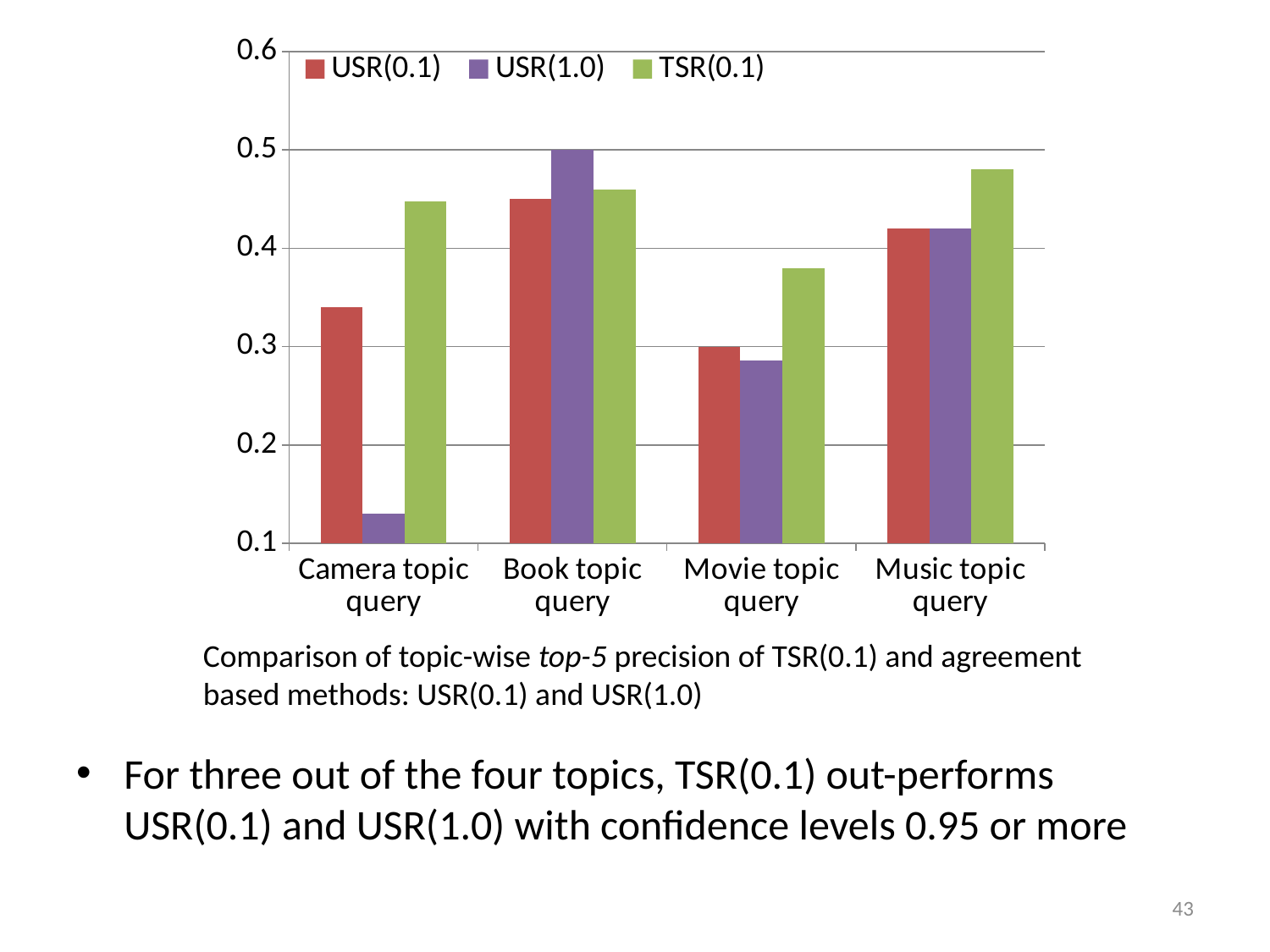
Is the value of TSR(0.1) for the Movie topic query greater or less than 0.4? less What kind of chart is shown on the slide? bar chart How many topic query categories are shown on the x axis? 4 Is the value of USR(0.1) for the Book topic query greater or less than 0.4? greater Is the value of TSR(0.1) for the Music topic query greater or less than 0.4? greater Which colour represents the TSR(0.1) series in the legend? green For the Book topic query, which is larger: USR(1.0) or TSR(0.1)? USR(1.0) Which series has the lowest value for the Camera topic query? USR(1.0) For the Camera topic query, which is larger: USR(0.1) or USR(1.0)? USR(0.1) Which series has the highest value for the Camera topic query? TSR(0.1) How many series does the legend list? 3